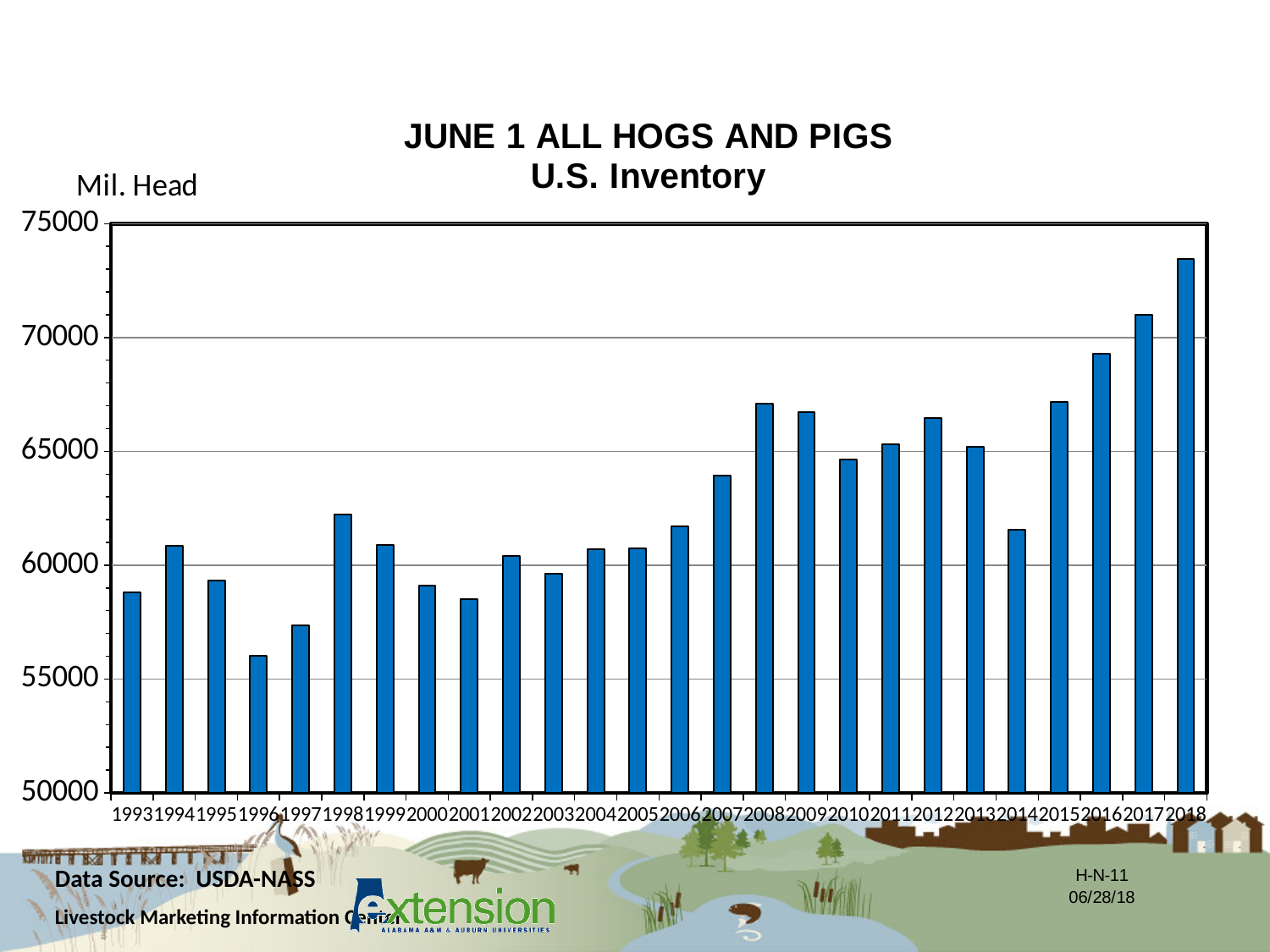
Is the value for 1996 greater or less than 60000? less Is the value for 2008 greater or less than 65000? greater Is the value for 2014 greater or less than 65000? less Which year has the highest June 1 all hogs and pigs inventory? 2018 How many years are plotted on the chart? 26 Which year has the larger inventory, 2008 or 2014? 2008 Which year has the lowest June 1 all hogs and pigs inventory? 1996 Overall, does the inventory rise or fall from 1993 to 2018? Rise What unit is shown on the vertical axis label? Mil. Head What kind of chart is shown on the slide? Bar chart